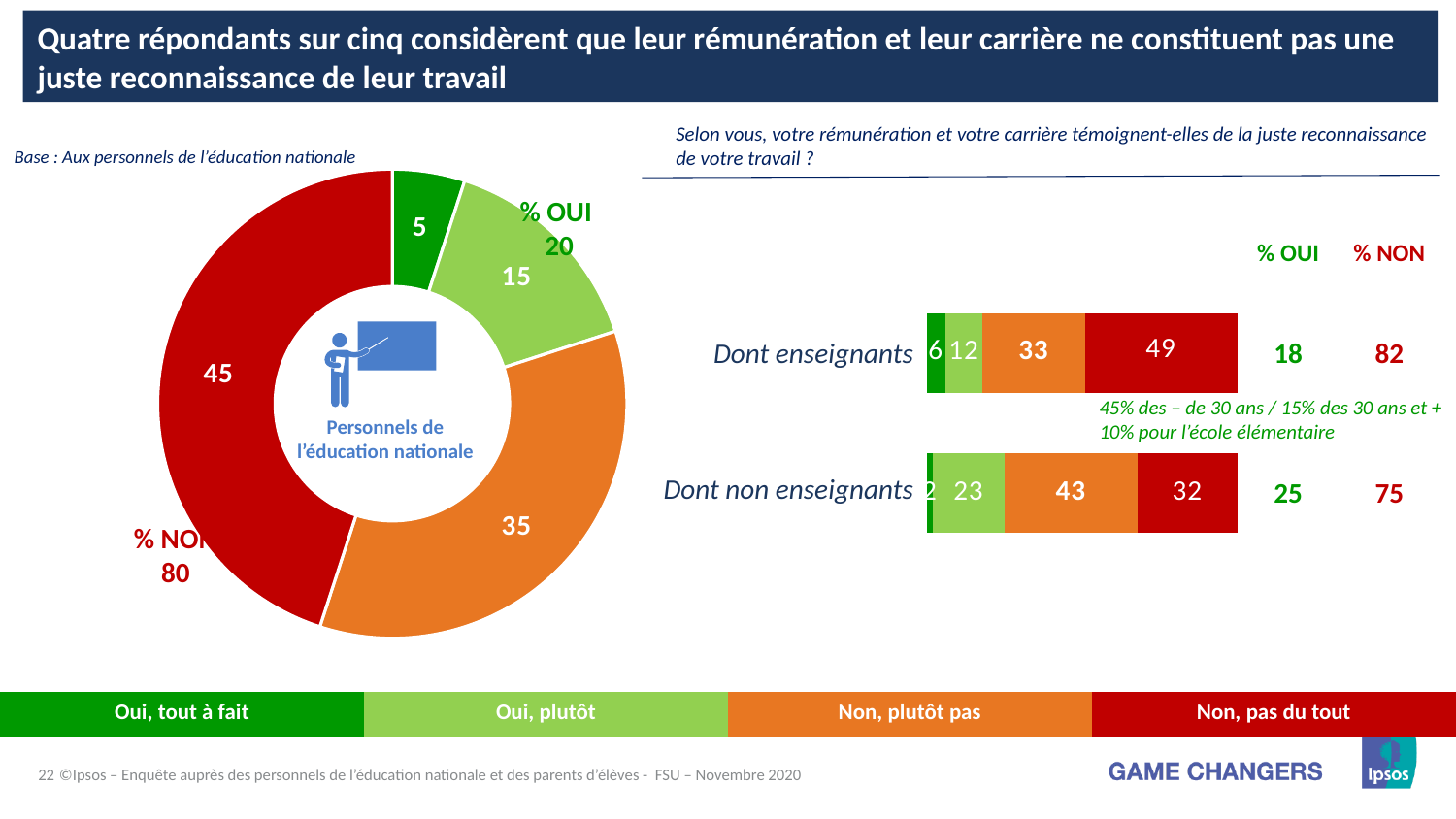
In the stacked bar chart on the right, which group has the larger "Oui, plutôt" value, "Dont enseignants" or "Dont non enseignants"? Dont non enseignants In the donut chart on the left, what is the value for "Non, pas du tout"? 45 In the stacked bar chart on the right, what is the value for "Non, plutôt pas" for "Dont non enseignants"? 43 In the donut chart on the left, what is the difference between "Non, pas du tout" and "Non, plutôt pas"? 10 In the donut chart on the left, what is the total % NON shown? 80 In the stacked bar chart on the right, what is the % NON for "Dont enseignants"? 82 In the stacked bar chart on the right, what is the value for "Non, pas du tout" for "Dont enseignants"? 49 In the donut chart on the left, which category has the largest share? Non, pas du tout In the donut chart on the left, what is the value for "Oui, tout à fait"? 5 In the donut chart on the left, which category has the smallest share? Oui, tout à fait What kind of chart is shown on the right side of the slide? Stacked bar chart How many categories does the legend at the bottom of the slide list? 4